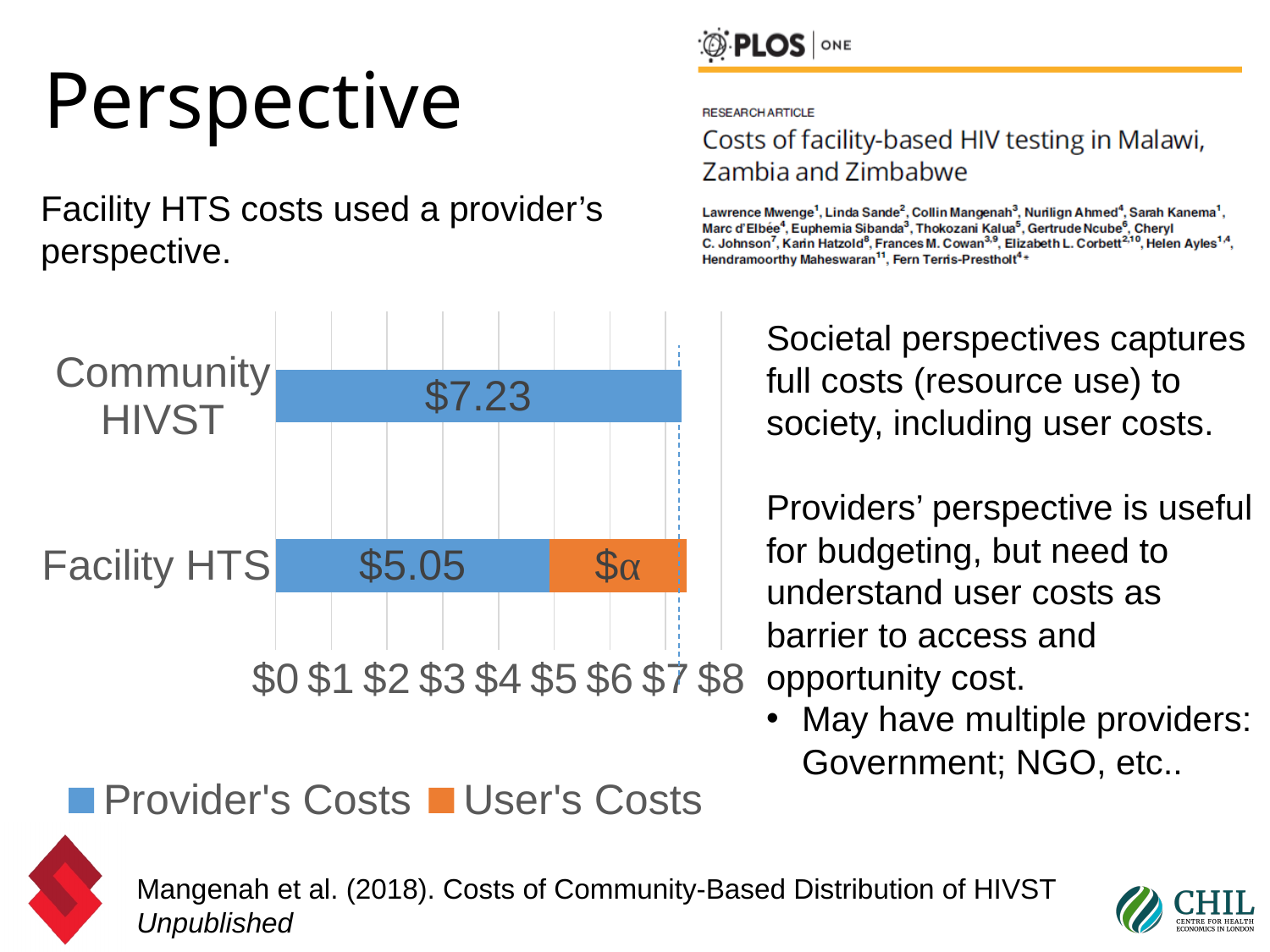
What is the difference between the Provider's Costs for Community HIVST and Facility HTS? $2.18 What kind of chart is shown on the slide? Stacked bar chart What label is shown on the User's Costs segment of the Facility HTS bar? $α Which colour represents User's Costs in the chart legend? Orange How many categories are plotted on the chart? 2 Which category has the higher Provider's Costs, Community HIVST or Facility HTS? Community HIVST Is the Provider's Costs value for Community HIVST greater or less than $6? greater Is the Provider's Costs value for Facility HTS greater or less than $6? less What is the Provider's Costs value for Community HIVST? $7.23 How many series does the chart legend list? 2 What is the Provider's Costs value for Facility HTS? $5.05 Which category has the lowest Provider's Costs? Facility HTS